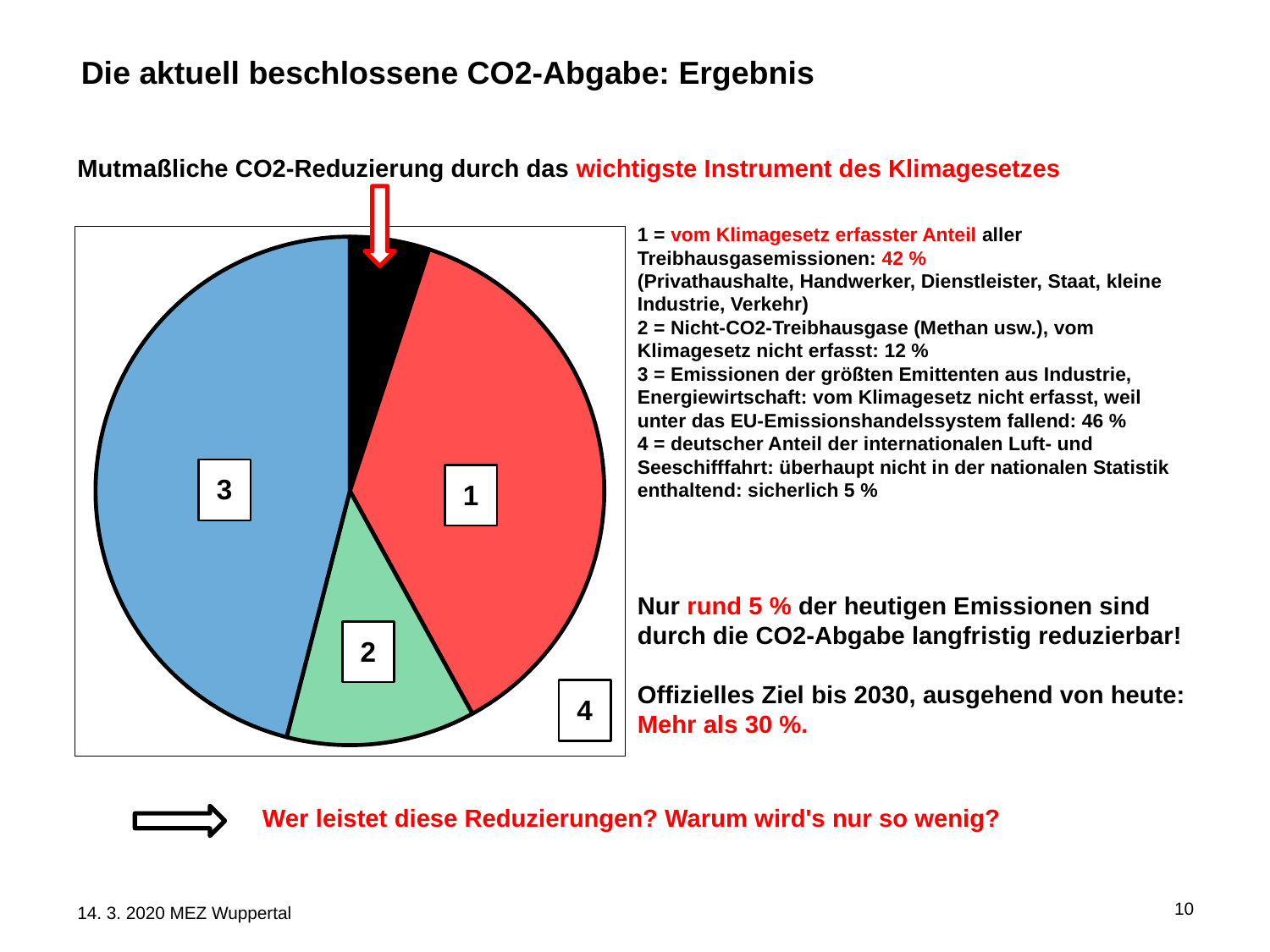
What is the difference in percentage points between slice 3 and slice 1? 4 % Which is larger, slice 1 or slice 2? slice 1 According to the slide text, what share of all greenhouse gas emissions does slice 1 (vom Klimagesetz erfasster Anteil) represent? 42 % Which numbered slice of the pie chart is the largest? 3 What kind of chart is shown on the slide? pie chart What colour is slice 3 in the pie chart? blue What is the difference in percentage points between slice 1 and slice 2? 30 % What percentage is given for slice 4 (deutscher Anteil der internationalen Luft- und Seeschifffahrt)? 5 % What percentage is given for slice 2 (Nicht-CO2-Treibhausgase)? 12 % What is the official reduction target by 2030 stated on the slide? Mehr als 30 % What colour is slice 1 in the pie chart? red What percentage is given for slice 3 (Emissionen der größten Emittenten aus Industrie, Energiewirtschaft)? 46 %